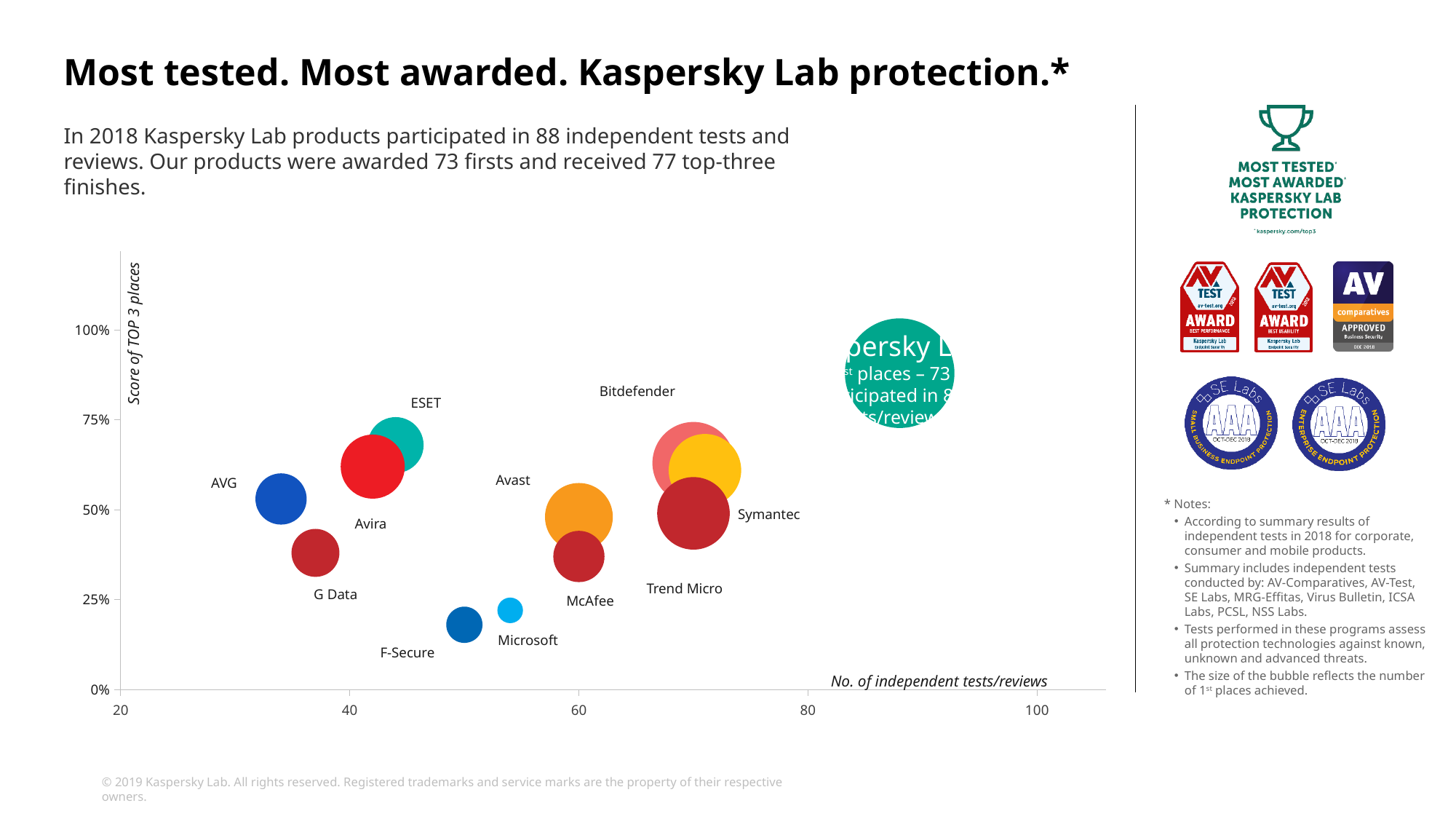
What is the title of the y axis of the chart? Score of TOP 3 places What is the title of the x axis of the chart? No. of independent tests/reviews Which vendor has the highest score of TOP 3 places in the chart? Kaspersky Lab Is the score of TOP 3 places for F-Secure greater or less than 25%? less Is the number of independent tests/reviews for Kaspersky Lab greater or less than 80? greater Which vendor has the lowest score of TOP 3 places in the chart? F-Secure What kind of chart is shown on the slide? Bubble chart Is the score of TOP 3 places for Bitdefender greater or less than 50%? greater How many vendor bubbles are plotted in the chart? 12 Which has a higher score of TOP 3 places, AVG or G Data? AVG Which vendor participated in the fewest independent tests/reviews according to the chart? AVG